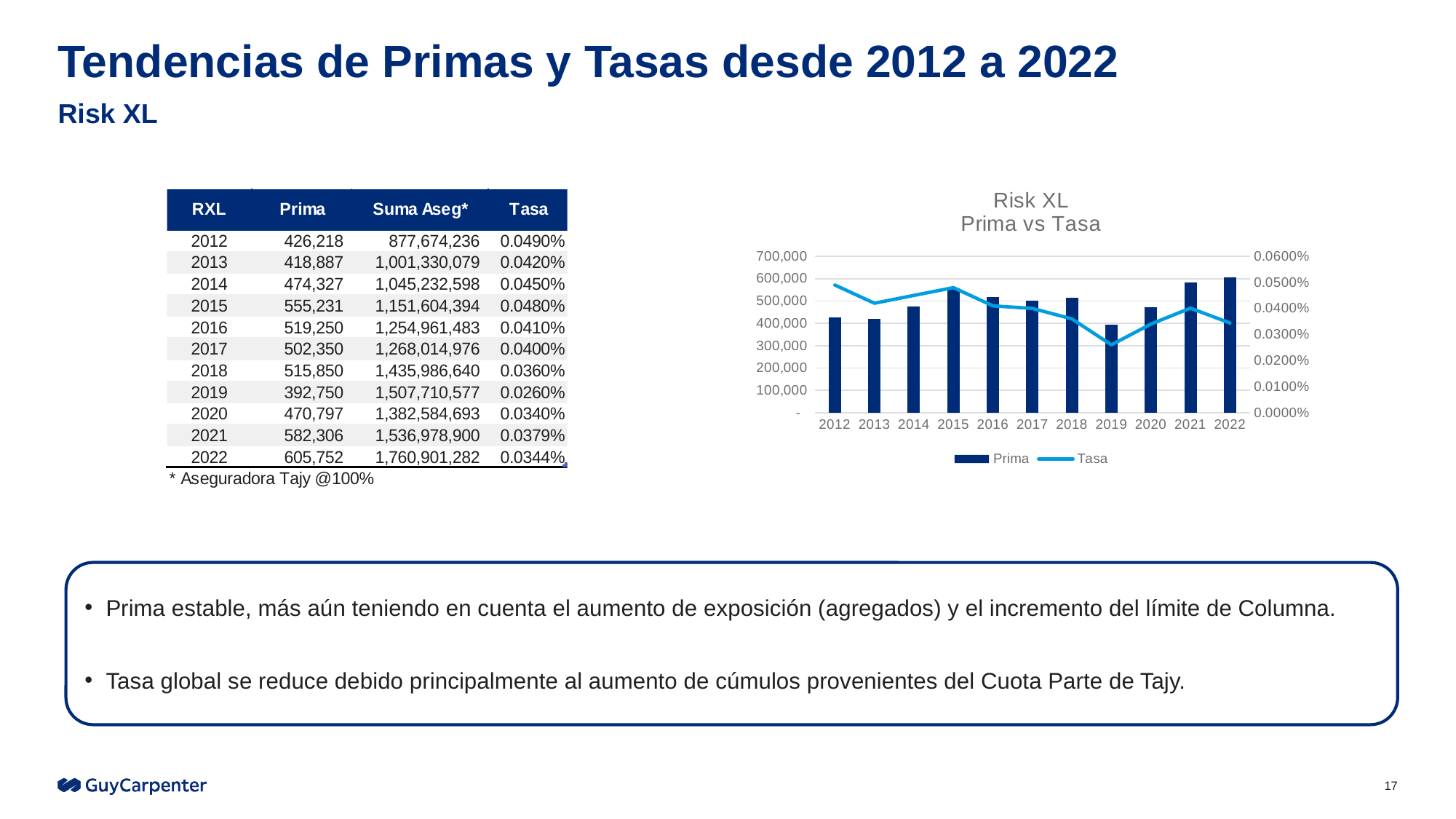
Which is larger, the Prima value for 2015 or for 2016? 2015 Does the Tasa line generally rise or fall from 2012 to 2019? fall In the 'Risk XL Prima vs Tasa' chart, which year has the lowest Prima bar? 2019 What is the Tasa value for 2019? 0.0260% What kind of chart is the 'Risk XL Prima vs Tasa' chart? A combined bar and line chart In the 'Risk XL Prima vs Tasa' chart, which year has the lowest Tasa value? 2019 What is the Prima value for 2015? 555,231 In the 'Risk XL Prima vs Tasa' chart, which year has the highest Prima bar? 2022 Is the Prima value for 2021 greater or less than 500,000? greater How many series does the legend of the 'Risk XL Prima vs Tasa' chart list? 2 What is the difference between the Prima value for 2022 and the Prima value for 2012? 179,534 How many years are shown on the x axis of the 'Risk XL Prima vs Tasa' chart? 11